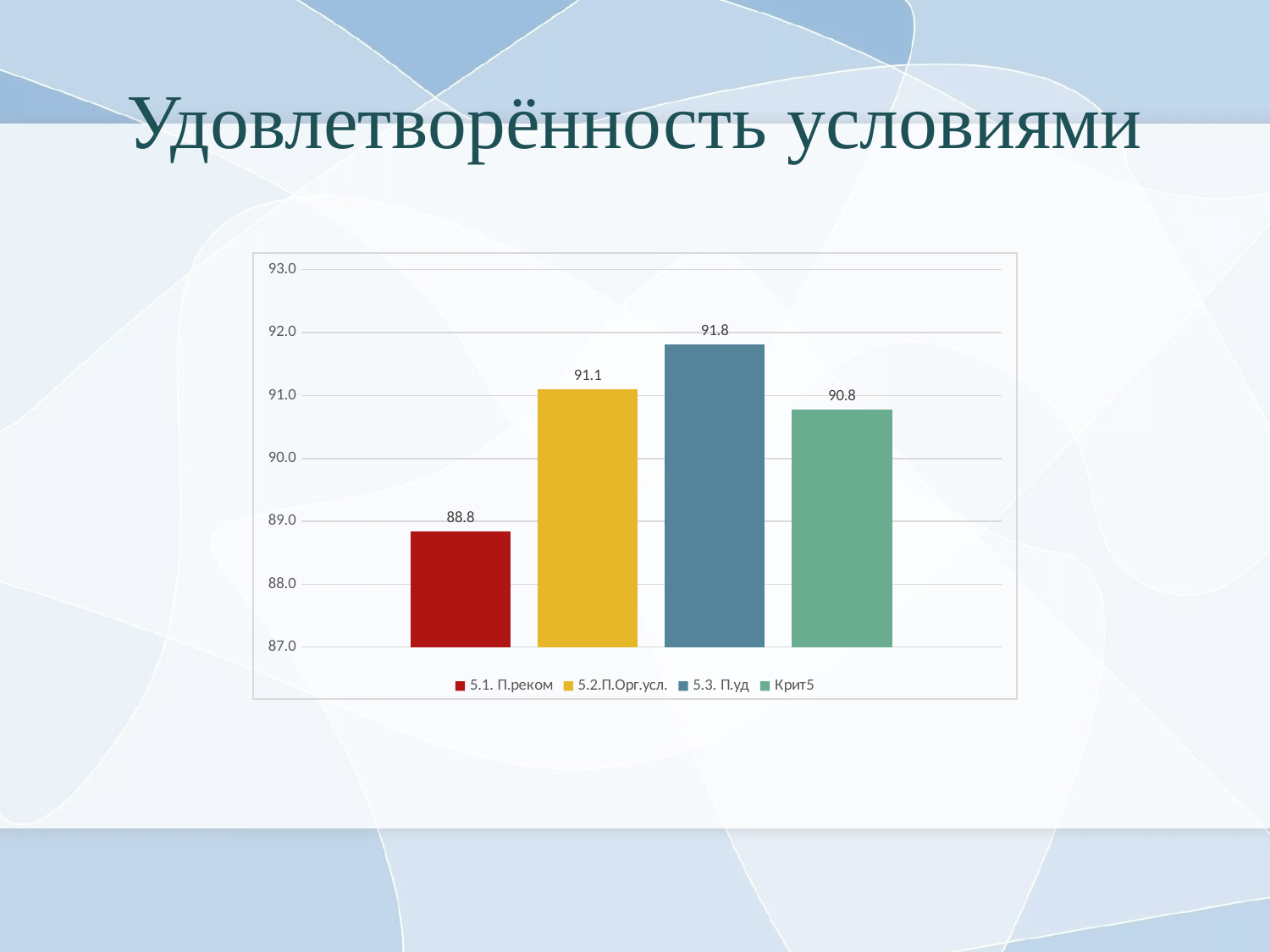
What is the difference between the values for 5.3. П.уд and 5.1. П.реком? 3.0 What is the title of the slide containing the chart? Удовлетворённость условиями Which is larger, the value for 5.2.П.Орг.усл. or the value for Крит5? 5.2.П.Орг.усл. What is the value for 5.2.П.Орг.усл.? 91.1 What is the value for 5.3. П.уд? 91.8 How many series does the legend list? 4 What is the value for Крит5? 90.8 Is the value for 5.1. П.реком greater or less than 90.0? less What is the value for 5.1. П.реком? 88.8 What kind of chart is shown on the slide? bar chart Which series has the highest value? 5.3. П.уд Which series has the lowest value? 5.1. П.реком